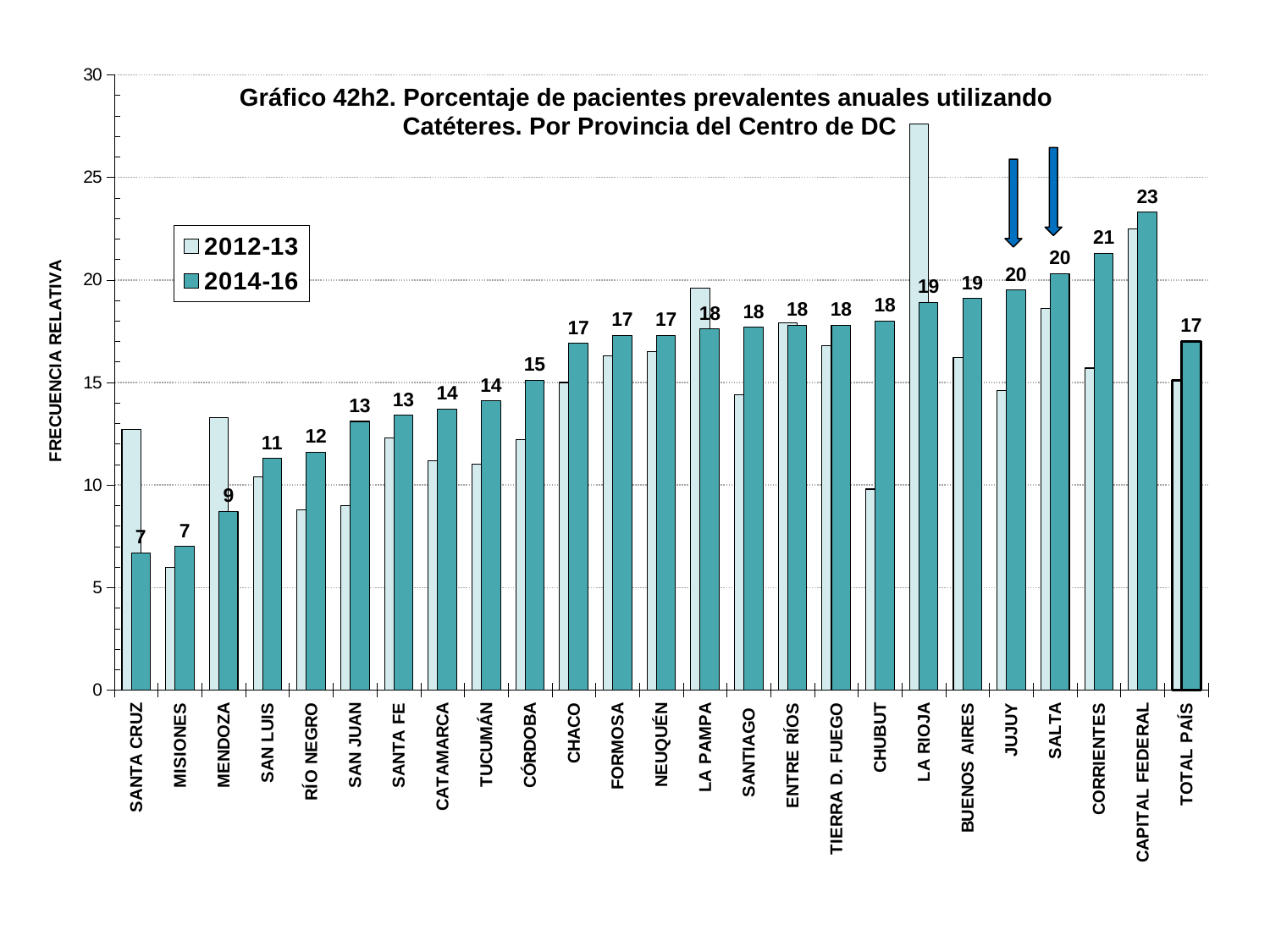
What is the 2014-16 value for MENDOZA? 9 How many series does the legend list? 2 Which province has the highest 2014-16 value? CAPITAL FEDERAL Which has the larger 2014-16 value, CORRIENTES or CÓRDOBA? CORRIENTES Do the 2014-16 values generally rise or fall from SANTA CRUZ to CAPITAL FEDERAL? rise What kind of chart is shown on the slide? bar chart Is the 2012-13 value for LA RIOJA greater or less than 25? greater How many categories are shown on the x axis? 25 What is the difference between the 2014-16 values for CAPITAL FEDERAL and SANTA CRUZ? 16 What is the 2014-16 value for CAPITAL FEDERAL? 23 What is the 2014-16 value for TOTAL PAÍS? 17